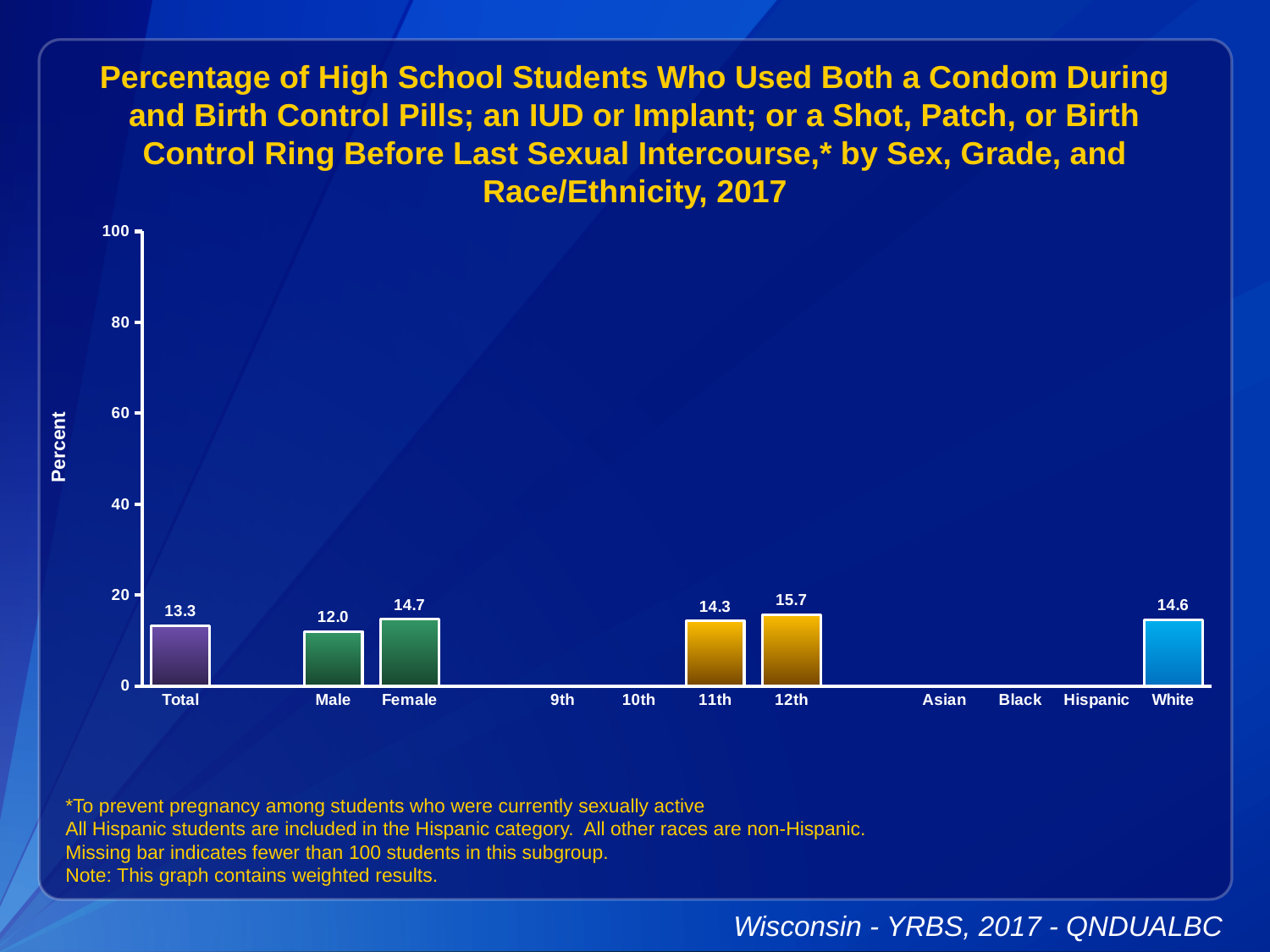
Which is larger, the value for 11th grade or the value for 12th grade? 12th What is the value for White? 14.6 Is the value for Total greater or less than 20? less What is the value for Female? 14.7 What is the label of the y axis? Percent Which category has the lowest value among the bars shown? Male What is the difference between the Female and Male values? 2.7 What is the value for Total? 13.3 How many categories have a bar plotted on the chart? 6 Which category has the highest value among the bars shown? 12th What kind of chart is shown on the slide? bar chart What is the value for 12th grade? 15.7